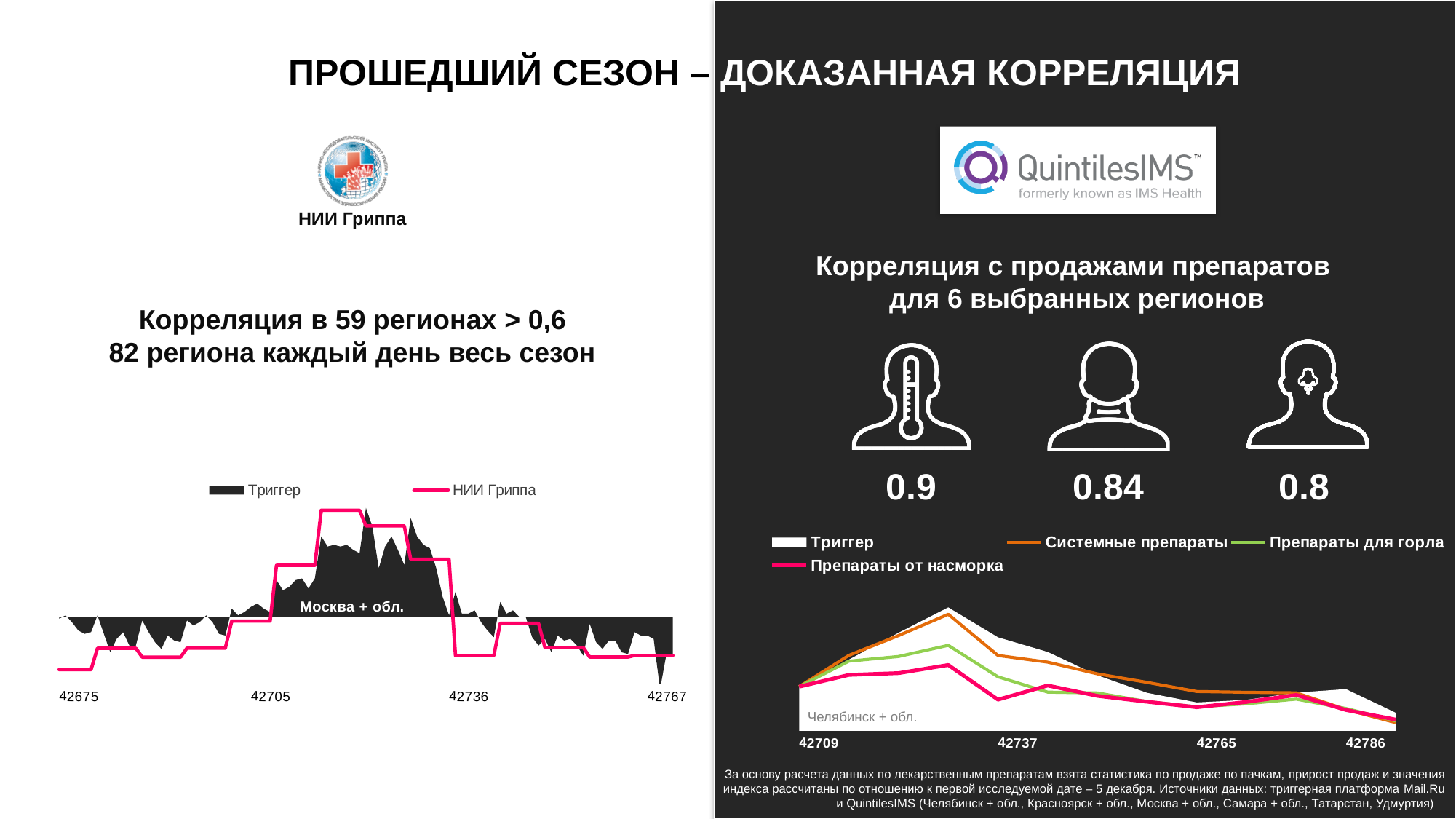
On the right chart (Челябинск + обл.), what is the last x-axis tick label? 42786 On the right chart (Челябинск + обл.), how many x-axis tick labels are shown? 4 On the right chart (Челябинск + обл.), how many series does the legend list? 4 On the left chart (Москва + обл.), what are the two legend entries? Триггер and НИИ Гриппа On the left chart (Москва + обл.), what is the first x-axis tick label? 42675 On the right chart (Челябинск + обл.), which series is drawn in orange? Системные препараты On the left chart (Москва + обл.), is the НИИ Гриппа series drawn as a line or as bars? a line On the right chart (Челябинск + обл.), does the Системные препараты line overall rise or fall from its peak near 42730 to the end at 42786? fall On the right chart (Челябинск + обл.), which series is drawn as a filled white area rather than a line? Триггер On the left chart (Москва + обл.), how many series does the legend list? 2 On the right chart (Челябинск + обл.), what is the first x-axis tick label? 42709 On the left chart (Москва + обл.), what is the last x-axis tick label? 42767